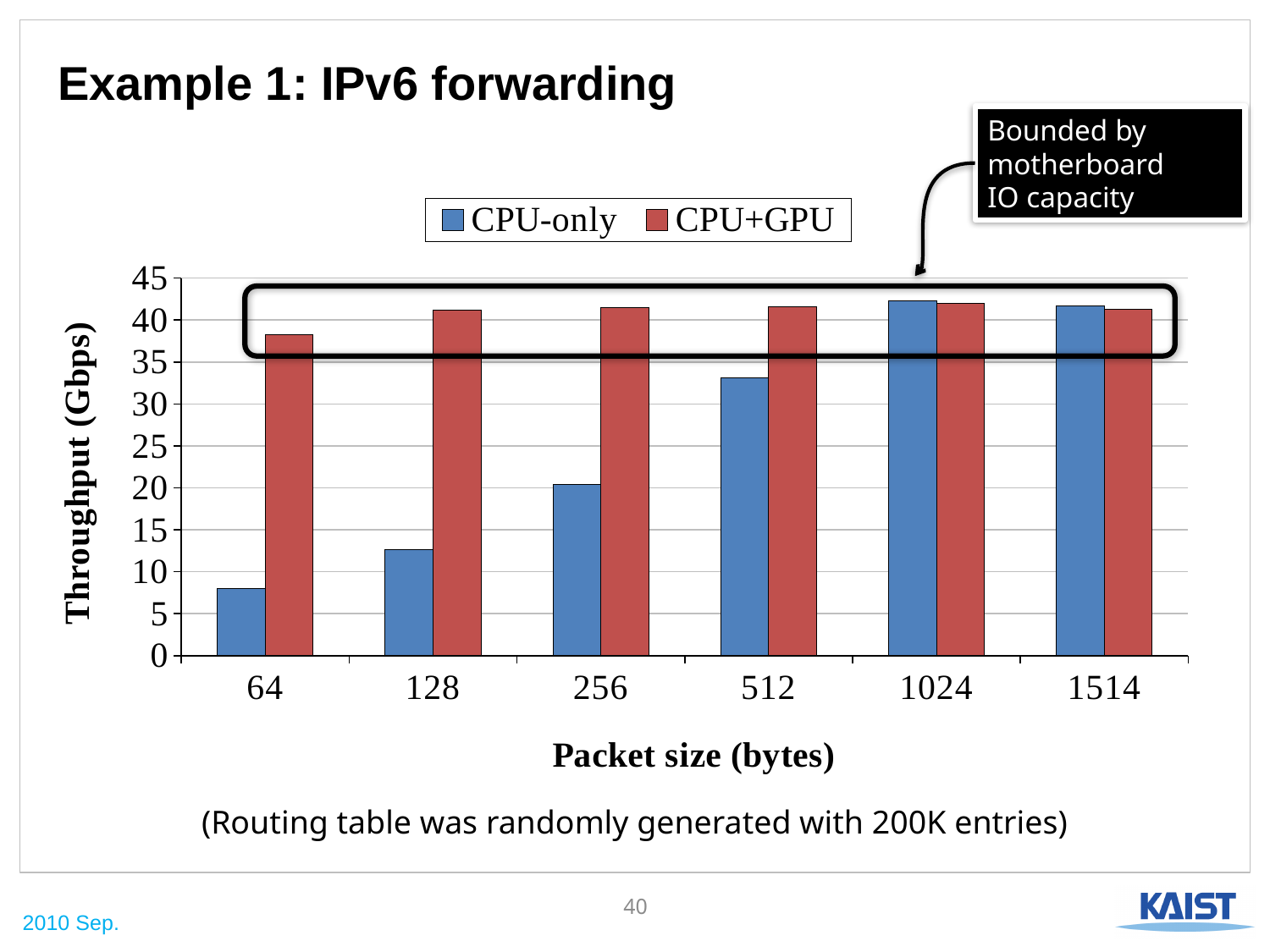
At packet size 64, which is larger: CPU-only or CPU+GPU throughput? CPU+GPU What are the two series named in the legend? CPU-only and CPU+GPU How many series does the legend list? 2 At packet size 512, which is larger: CPU-only or CPU+GPU throughput? CPU+GPU What kind of chart is shown on the slide? bar chart Does the CPU-only throughput generally rise or fall as packet size increases from 64 to 1024 bytes? rise How many packet sizes are shown on the x axis? 6 Is the CPU-only throughput at packet size 512 greater or less than 30 Gbps? greater Which packet size has the lowest CPU+GPU throughput? 64 Is the CPU+GPU throughput at packet size 64 greater or less than 40 Gbps? less Which packet size has the lowest CPU-only throughput? 64 Is the CPU-only throughput at packet size 64 greater or less than 10 Gbps? less